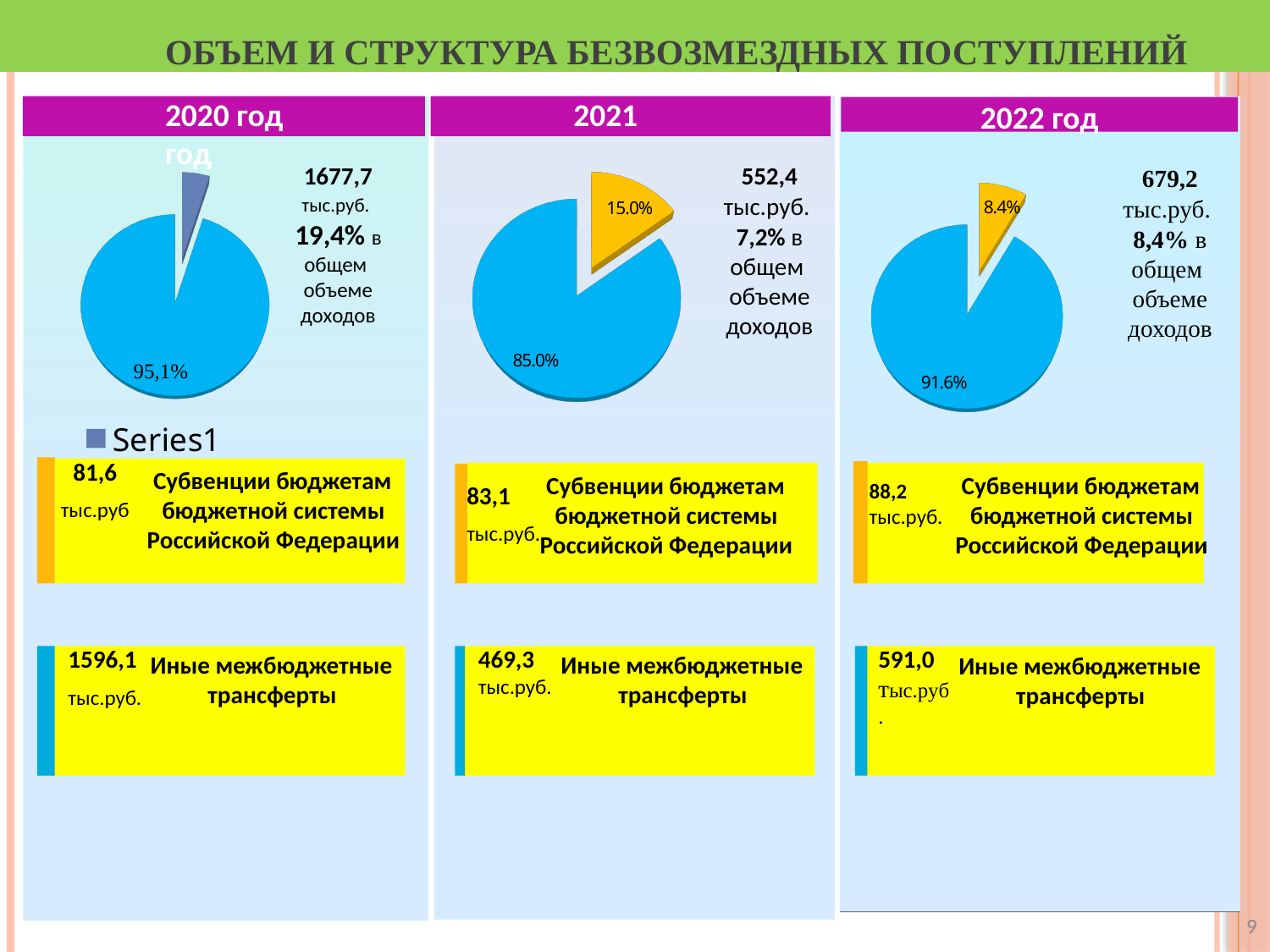
In the 2020 год pie chart, what percentage is shown on the large blue slice? 95,1% In the 2022 год pie chart, what percentage is shown on the larger (blue) slice? 91.6% In the 2021 pie chart, which slice is larger, the blue one or the yellow one? the blue one Comparing the 2021 and 2022 год pie charts, which one has the larger yellow slice? 2021 In the 2021 pie chart, what is the difference between the two slice percentages? 70.0% In the 2022 год pie chart, what percentage is shown on the smaller (yellow) slice? 8.4% In the 2021 pie chart, what percentage is shown on the smaller (yellow) slice? 15.0% What legend entry is shown below the 2020 год pie chart? Series1 How many slices does the 2021 pie chart have? 2 In the 2022 год pie chart, what is the difference between the two slice percentages? 83.2% In the 2021 pie chart, what percentage is shown on the larger (blue) slice? 85.0% What kind of chart is shown in the 2020 год panel? pie chart